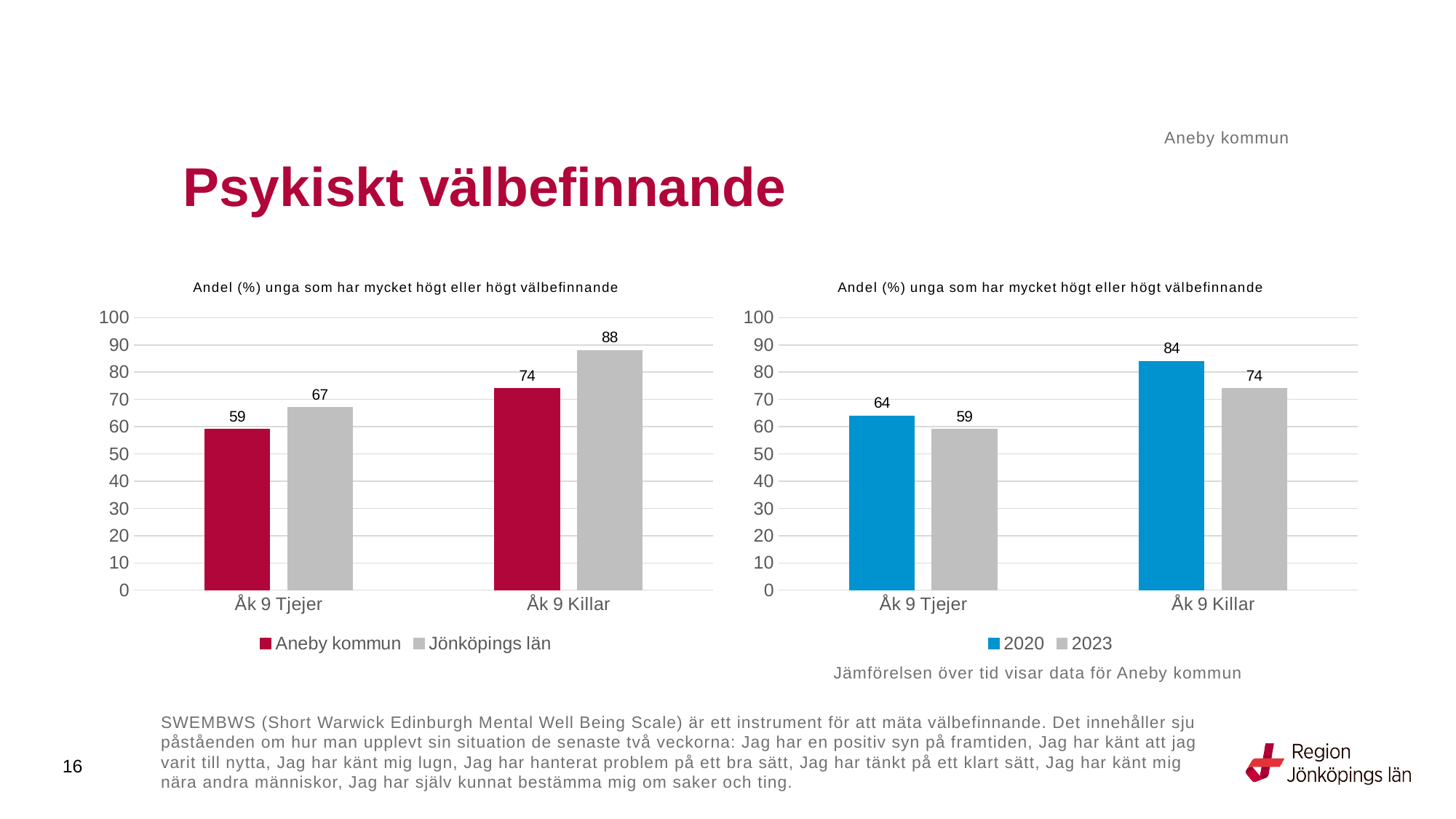
How many series does the legend of the left chart list? 2 In the right chart, what is the difference between the 2020 and 2023 values for Åk 9 Killar? 10 In the right chart, what is the value for 2020 for Åk 9 Killar? 84 In the right chart, what is the value for 2023 for Åk 9 Tjejer? 59 In the right chart, which bar is the lowest? 2023, Åk 9 Tjejer In the left chart, what is the value for Aneby kommun for Åk 9 Tjejer? 59 In the left chart, what is the difference between Jönköpings län and Aneby kommun for Åk 9 Killar? 14 In the left chart, what is the value for Jönköpings län for Åk 9 Killar? 88 In the left chart, which bar is the highest? Jönköpings län, Åk 9 Killar What kind of chart is the right chart? bar chart In the right chart, is the 2020 value for Åk 9 Tjejer larger or smaller than the 2023 value? larger In the right chart, did the value for Åk 9 Killar rise or fall from 2020 to 2023? fall